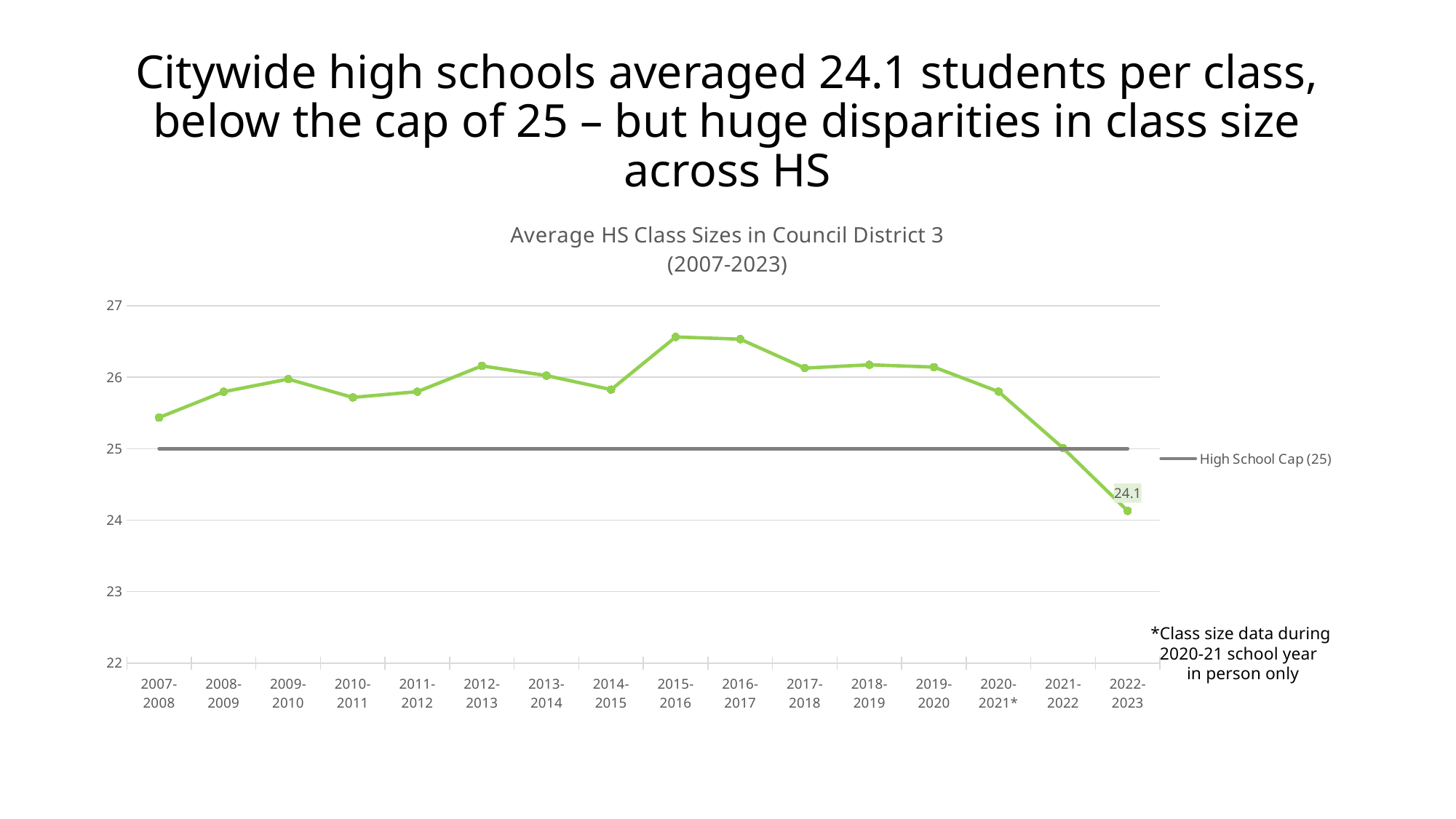
How many school years are plotted on the x axis? 16 Is the value for 2007-2008 greater or less than 25? greater Which is larger, the value for 2012-2013 or the value for 2010-2011? 2012-2013 What is the average HS class size for 2022-2023? 24.1 Is the value for 2010-2011 greater or less than 26? less Do the values rise or fall from 2019-2020 to 2022-2023? fall What is the title of the chart? Average HS Class Sizes in Council District 3 (2007-2023) What kind of chart is shown on the slide? line chart Is the value for 2022-2023 greater or less than 25? less What value does the High School Cap line represent? 25 Which school year has the lowest average HS class size? 2022-2023